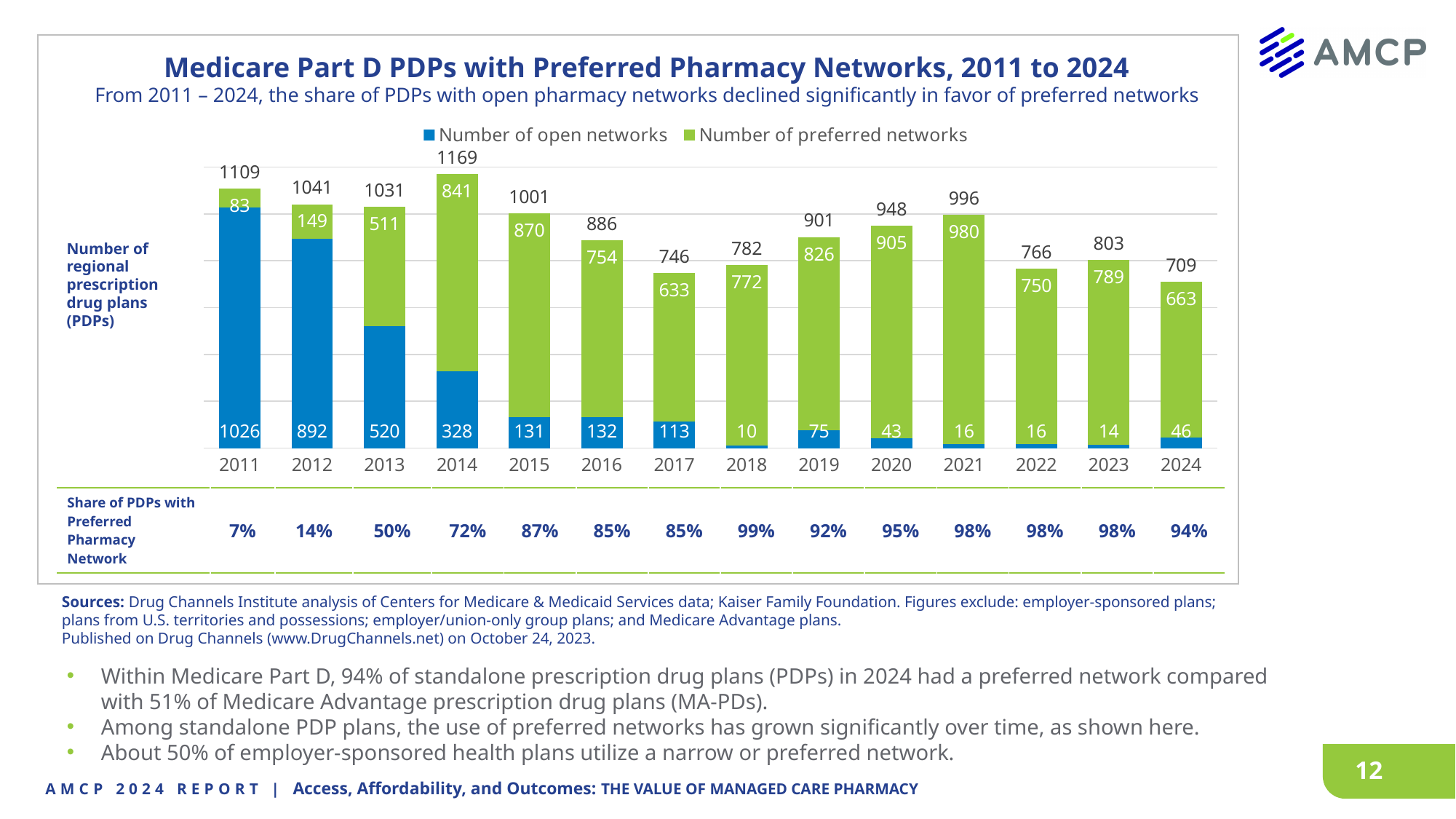
How many series does the legend list? 2 What type of chart is shown on the slide? Stacked bar chart How many years are shown on the x axis of the chart? 14 What is the number of preferred networks in 2021? 980 What is the number of open networks in 2011? 1026 What is the difference between the number of open networks in 2011 and in 2024? 980 What is the total number of regional PDPs in 2014? 1169 Which year has the highest total number of PDPs? 2014 Which year has the lowest number of open networks? 2018 Which is larger, the number of preferred networks in 2015 or in 2016? 2015 Which year has the lowest total number of PDPs? 2024 Does the number of open networks rise or fall from 2011 to 2018? Fall